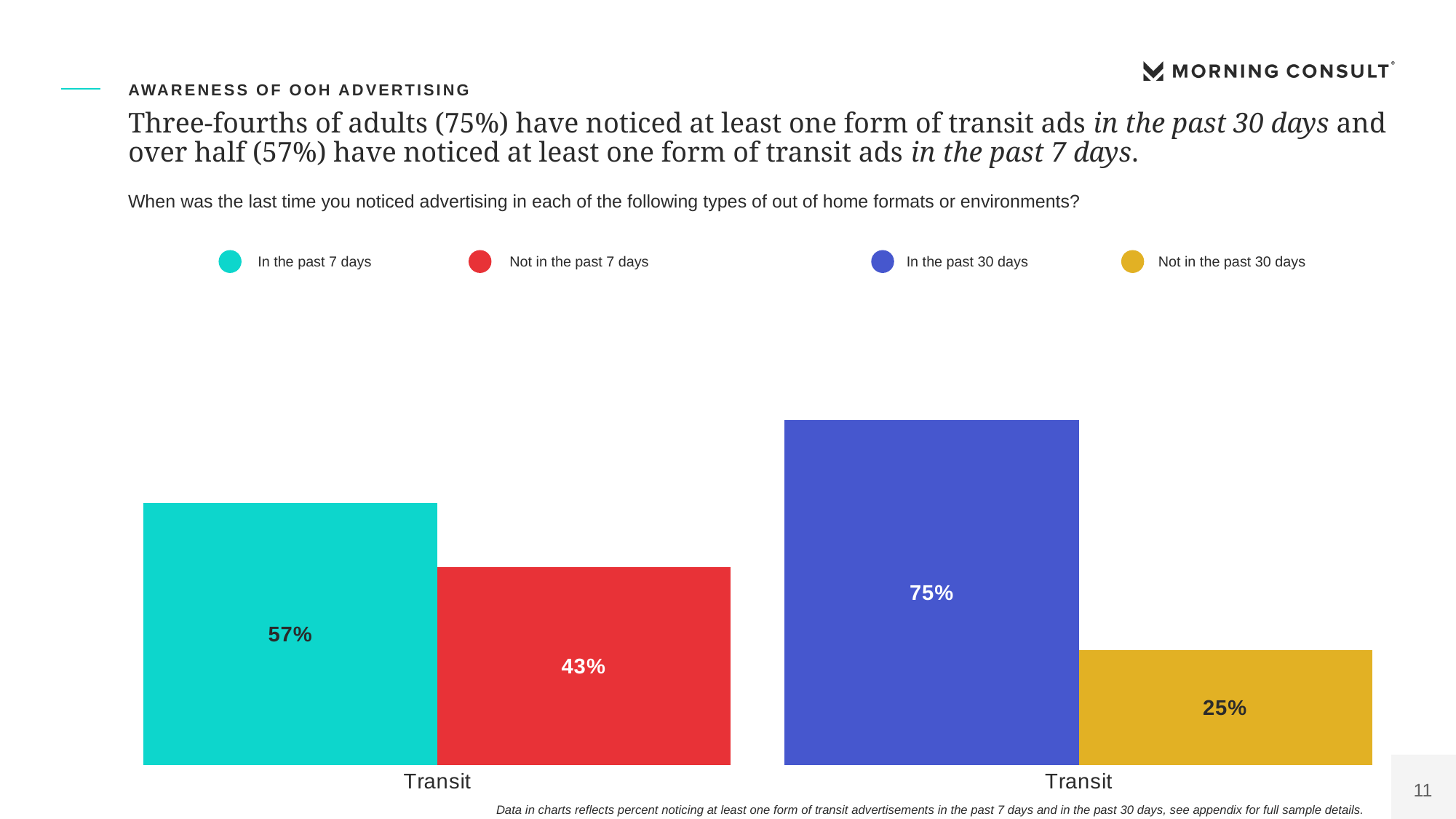
How many series does the legend list? 4 Which series has the lowest value in the chart? Not in the past 30 days Which is larger: the 'Not in the past 7 days' value or the 'Not in the past 30 days' value? Not in the past 7 days What colour is the bar for 'In the past 30 days'? Blue What is the difference between the 'In the past 7 days' value and the 'Not in the past 7 days' value? 14% What percentage of adults noticed transit ads in the past 7 days? 57% What percentage of adults did not notice transit ads in the past 7 days? 43% What kind of chart is shown on the slide? Bar chart Which series has the highest value in the chart? In the past 30 days What is the difference between the 'In the past 30 days' value and the 'In the past 7 days' value? 18% What percentage of adults noticed transit ads in the past 30 days? 75% What percentage of adults did not notice transit ads in the past 30 days? 25%